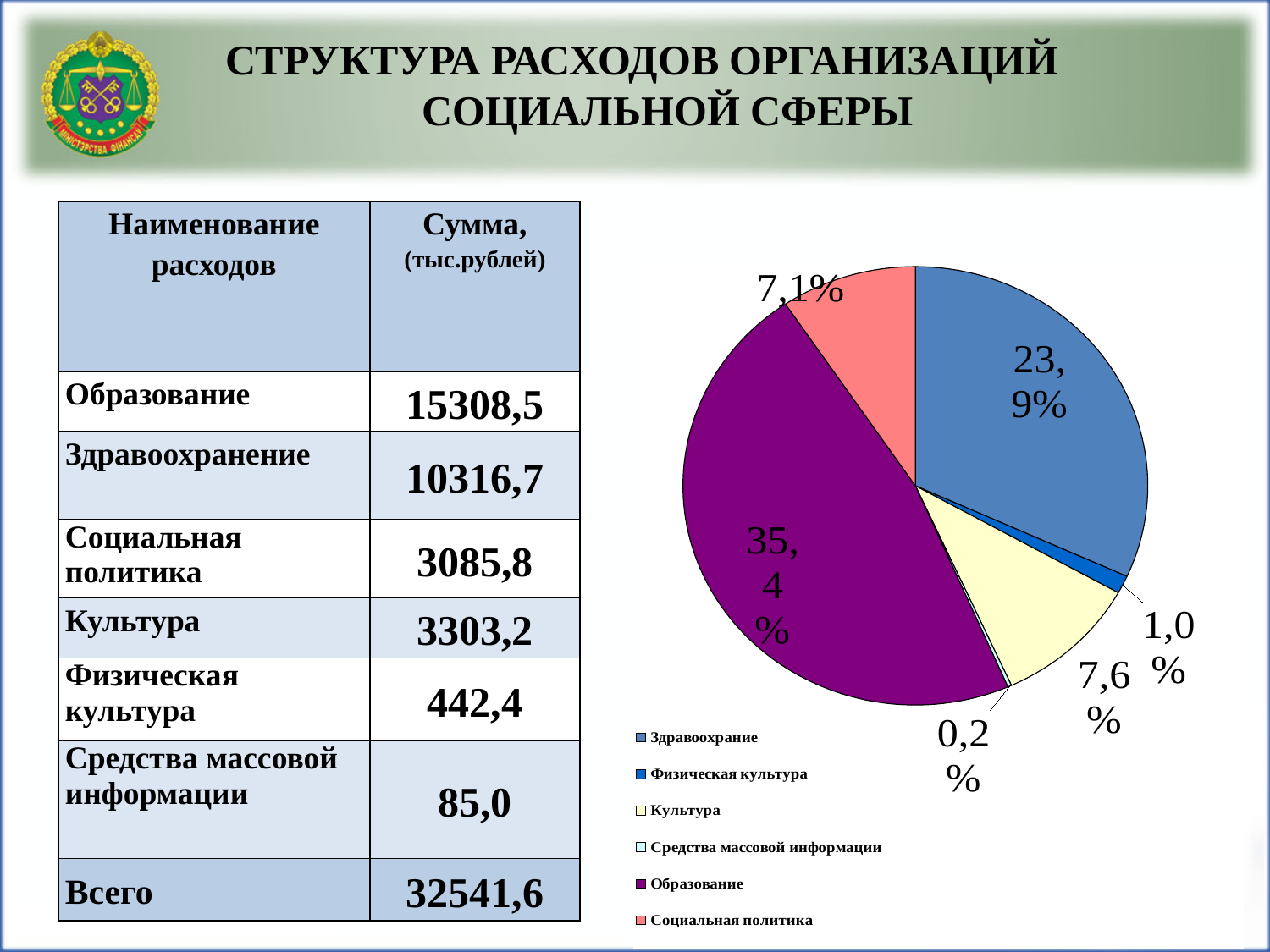
Which category has the smallest slice in the pie chart? Средства массовой информации Which slice is larger in the pie chart, Здравоохранение or Культура? Здравоохранение What percentage is shown for the Социальная политика slice of the pie chart? 7,1% What percentage is shown for the Физическая культура slice of the pie chart? 1,0% What colour is the Образование slice in the pie chart? Purple What percentage is shown for the Культура slice of the pie chart? 7,6% What percentage is shown for the Здравоохранение slice of the pie chart? 23,9% How many categories does the legend of the pie chart list? 6 What type of chart is shown on the slide? Pie chart What is the difference between the labelled percentages for Образование and Здравоохранение in the pie chart? 11,5% Which category has the largest slice in the pie chart? Образование What percentage is shown for the Образование slice of the pie chart? 35,4%